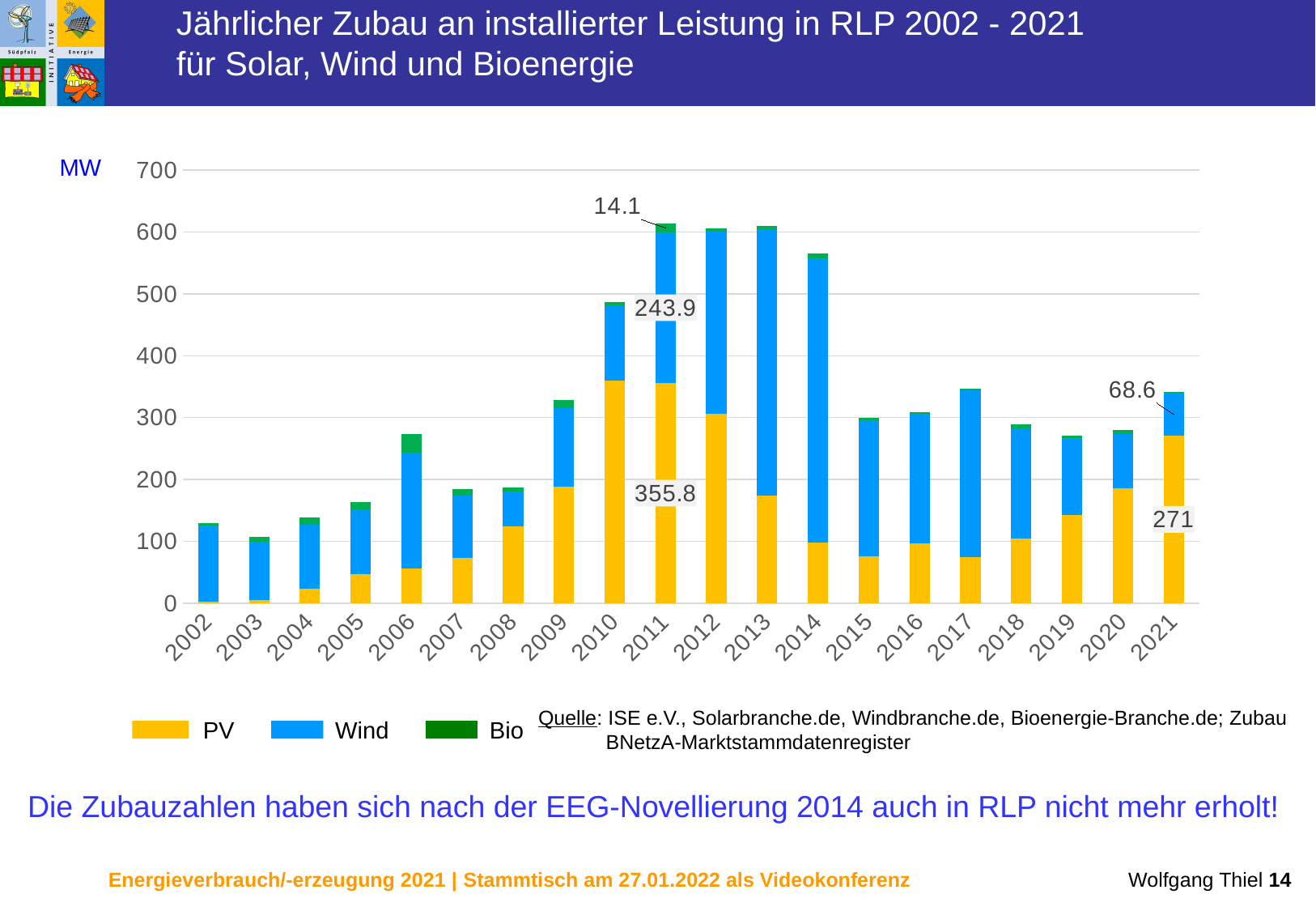
How many years are shown on the x axis? 20 Which year has the larger PV value, 2011 or 2021? 2011 Is the total value for 2010 greater or less than 400? greater How many series does the legend list? 3 What is the Wind value for 2021? 68.6 What is the PV value for 2011? 355.8 What kind of chart is shown on the slide? stacked bar chart What is the difference between the PV value for 2011 and the PV value for 2021? 84.8 What is the PV value for 2021? 271 What is the Bio value for 2011? 14.1 What is the total of the stacked bar for 2011? 613.8 What is the Wind value for 2011? 243.9